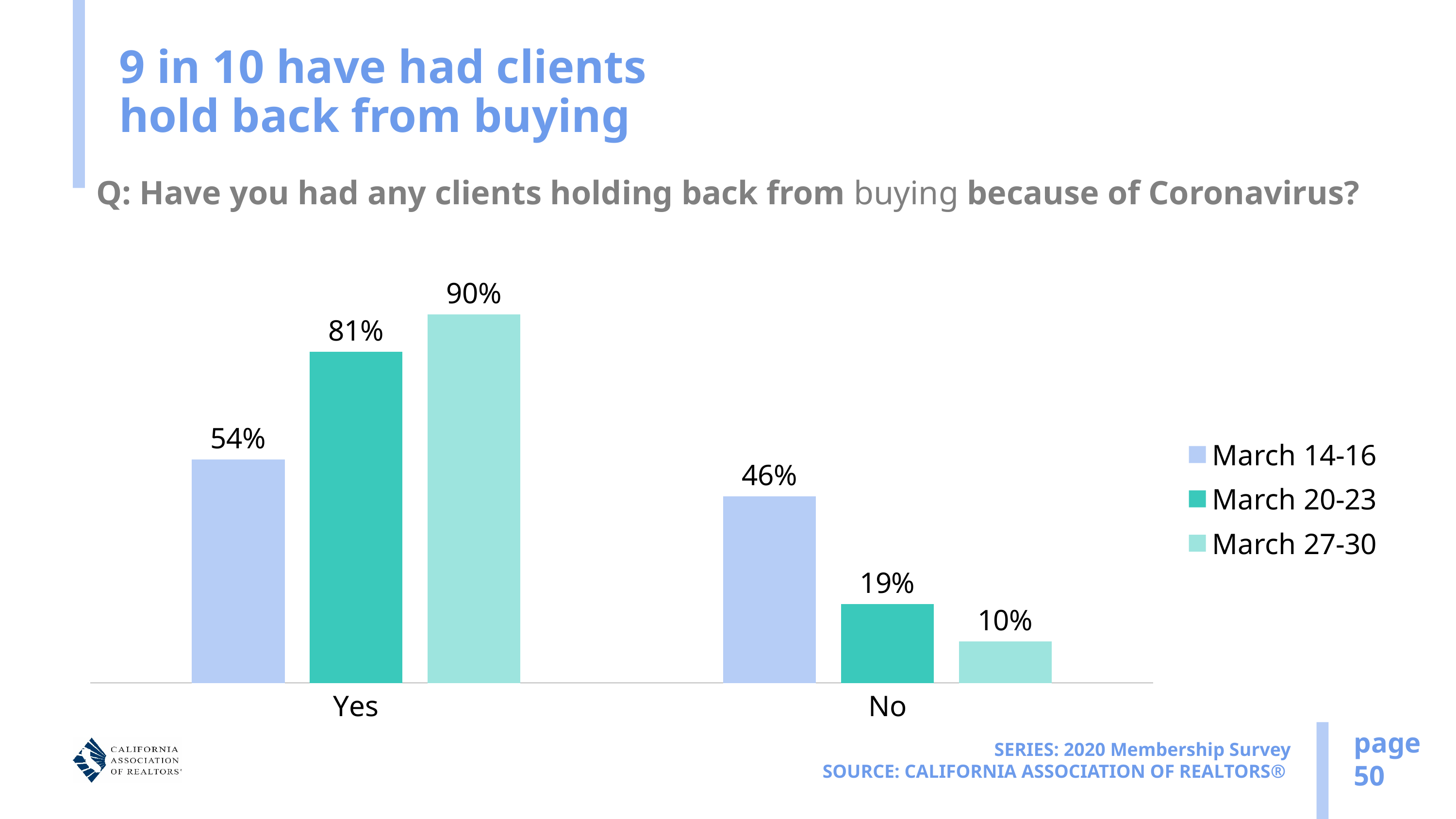
What percentage answered Yes in the March 20-23 survey? 81% How many response categories are shown on the x axis? 2 What is the difference between the No percentages for March 20-23 and March 27-30? 9% Which survey period has the lowest No percentage? March 27-30 How many series does the legend list? 3 What is the difference between the Yes percentages for March 27-30 and March 14-16? 36% What percentage answered Yes in the March 27-30 survey? 90% Which is larger: the Yes percentage for March 14-16 or the No percentage for March 14-16? Yes percentage for March 14-16 Which survey period has the highest Yes percentage? March 27-30 What kind of chart is shown on the slide? Bar chart What percentage answered No in the March 27-30 survey? 10% What percentage answered No in the March 14-16 survey? 46%